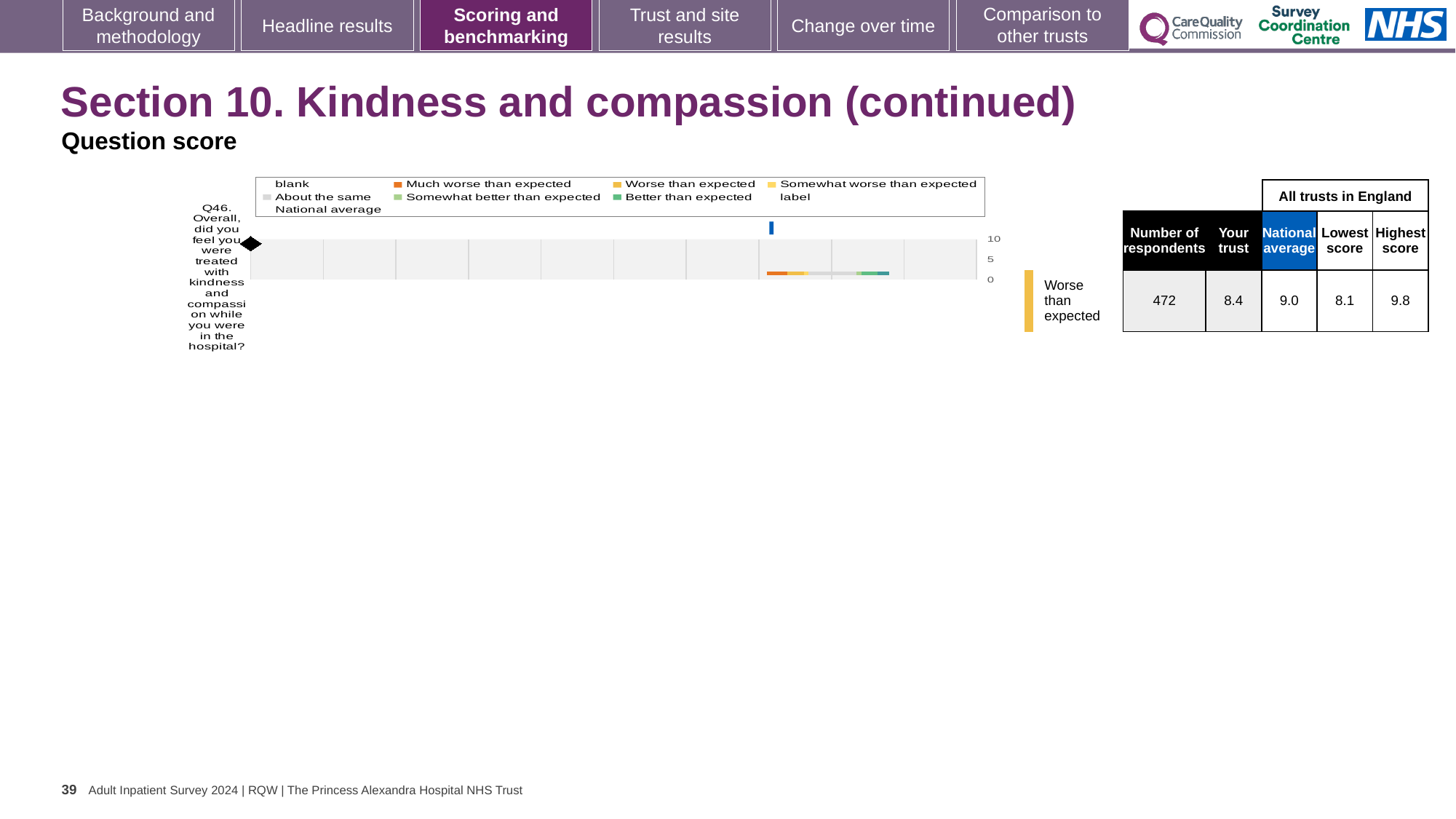
What is the National average score for Q46? 9.0 Which is larger for Q46, the Your trust score or the National average? National average Which question is plotted on the chart? Q46. Overall, did you feel you were treated with kindness and compassion while you were in the hospital? What is the difference between the Highest score and the Lowest score for Q46? 1.7 What kind of chart is shown on the slide? bar chart What is the Lowest score among all trusts in England for Q46? 8.1 What is the score for Your trust for Q46? 8.4 How many respondents answered Q46? 472 What is the highest value shown on the chart's axis? 10 How many questions are plotted on the chart? 1 What is the Highest score among all trusts in England for Q46? 9.8 What benchmarking category is the trust's score for Q46 placed in? Worse than expected